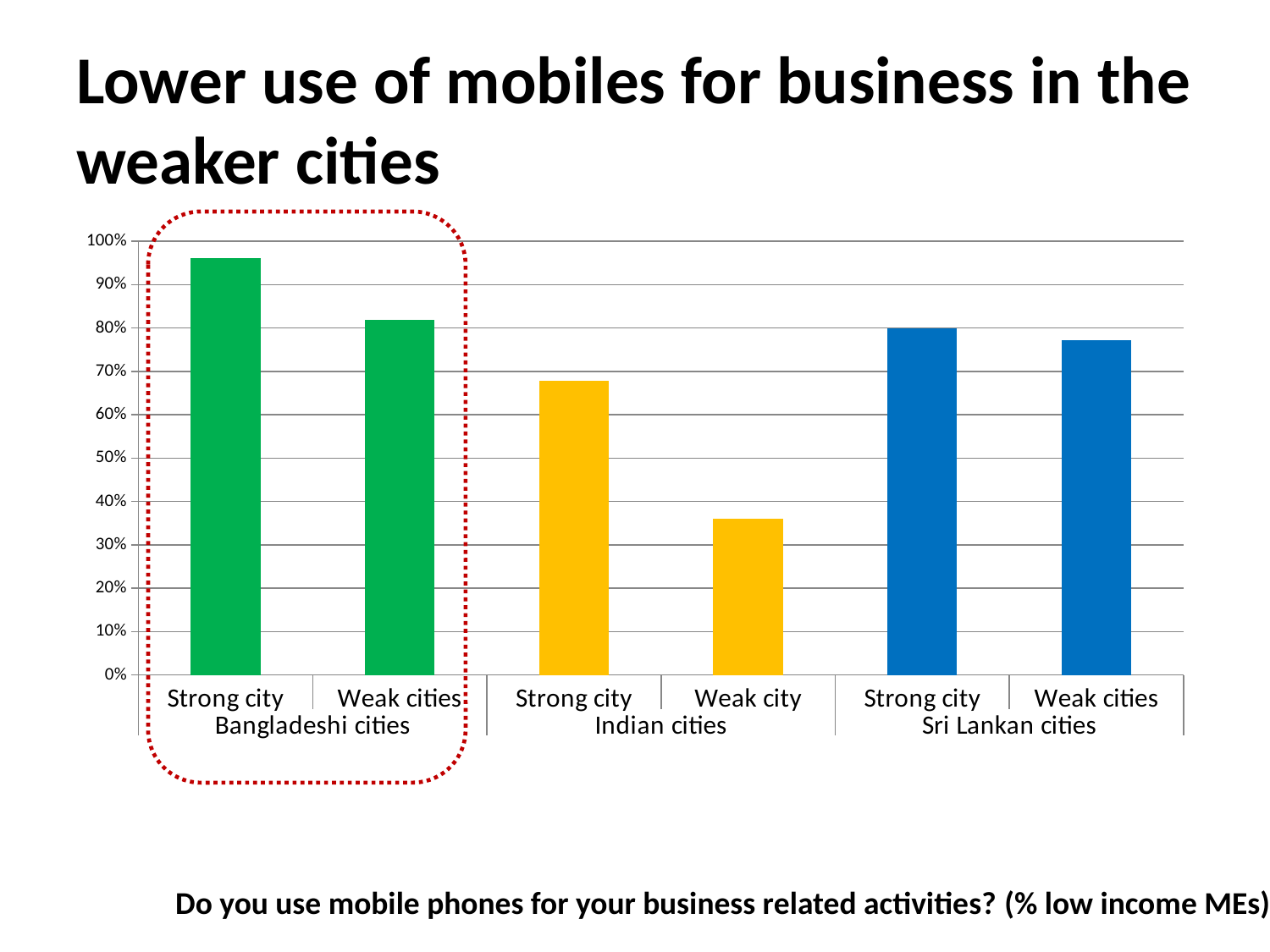
Is the value for Strong city in Indian cities greater or less than 60%? greater Within the Bangladeshi cities group, which is larger: Strong city or Weak cities? Strong city Which bar has the lowest value in the chart? Weak city, Indian cities Which country group is enclosed by the red dotted outline? Bangladeshi cities How many bars are plotted in the chart? 6 Is the value for Strong city in Bangladeshi cities greater or less than 90%? greater What kind of chart is shown on the slide? bar chart Which bar has the highest value in the chart? Strong city, Bangladeshi cities Is the value for Weak city in Indian cities greater or less than 40%? less How many country groups are shown along the x axis? 3 Which is larger: the Strong city value for Indian cities or the Strong city value for Sri Lankan cities? Sri Lankan cities Strong city